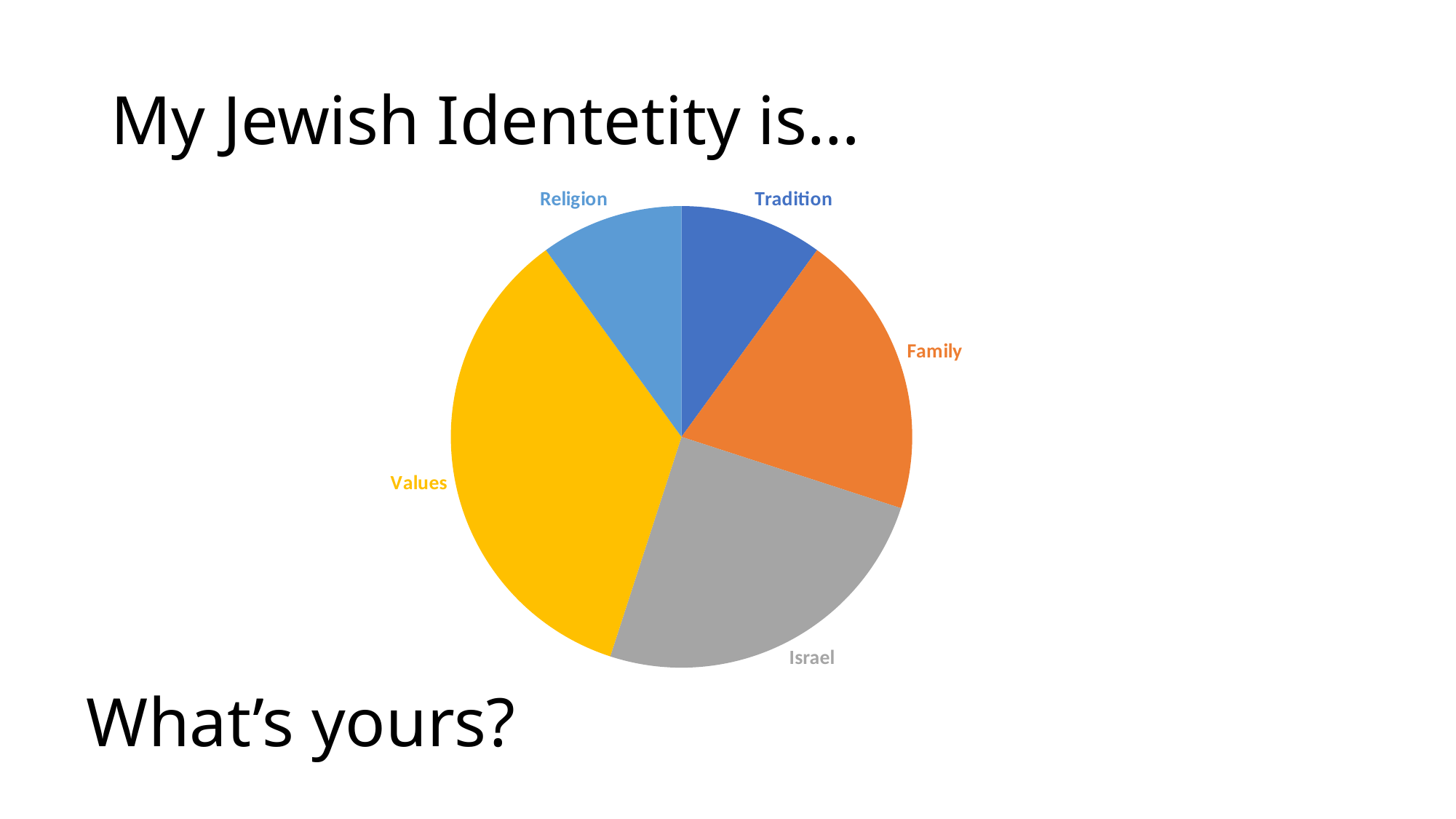
What colour is the Values slice of the pie chart? yellow Which category has the largest slice of the pie chart? Values Which slice is larger, Values or Israel? Values Which slice is larger, Israel or Religion? Israel Which slice is larger, Israel or Family? Israel What kind of chart is shown on the slide? pie chart How many slices does the pie chart have? 5 What colour is the Israel slice of the pie chart? grey